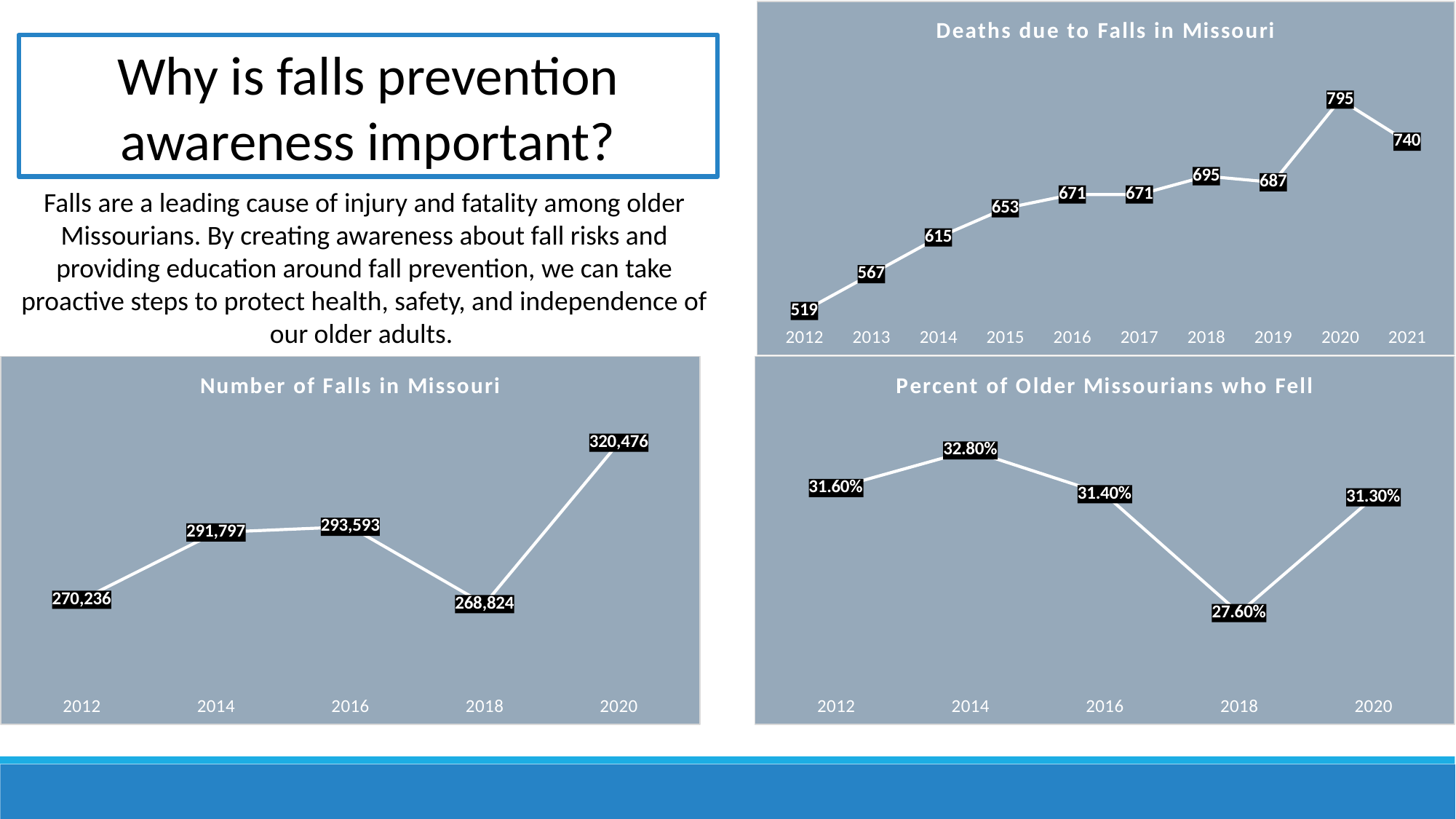
In the 'Percent of Older Missourians who Fell' chart, what is the difference between the 2014 and 2018 values? 5.20% In the 'Percent of Older Missourians who Fell' chart, which year has the highest value? 2014 In the 'Number of Falls in Missouri' chart, how many data points are plotted? 5 In the 'Deaths due to Falls in Missouri' chart, which year has the lowest value? 2012 In the 'Deaths due to Falls in Missouri' chart, how many deaths were recorded in 2020? 795 What type of chart is 'Deaths due to Falls in Missouri'? Line chart In the 'Deaths due to Falls in Missouri' chart, how many years are plotted? 10 In the 'Number of Falls in Missouri' chart, what is the value for 2018? 268,824 In the 'Percent of Older Missourians who Fell' chart, what is the value for 2018? 27.60% In the 'Number of Falls in Missouri' chart, is the value for 2014 or 2016 larger? 2016 In the 'Number of Falls in Missouri' chart, which year has the highest value? 2020 In the 'Deaths due to Falls in Missouri' chart, what is the difference between the 2020 and 2021 values? 55